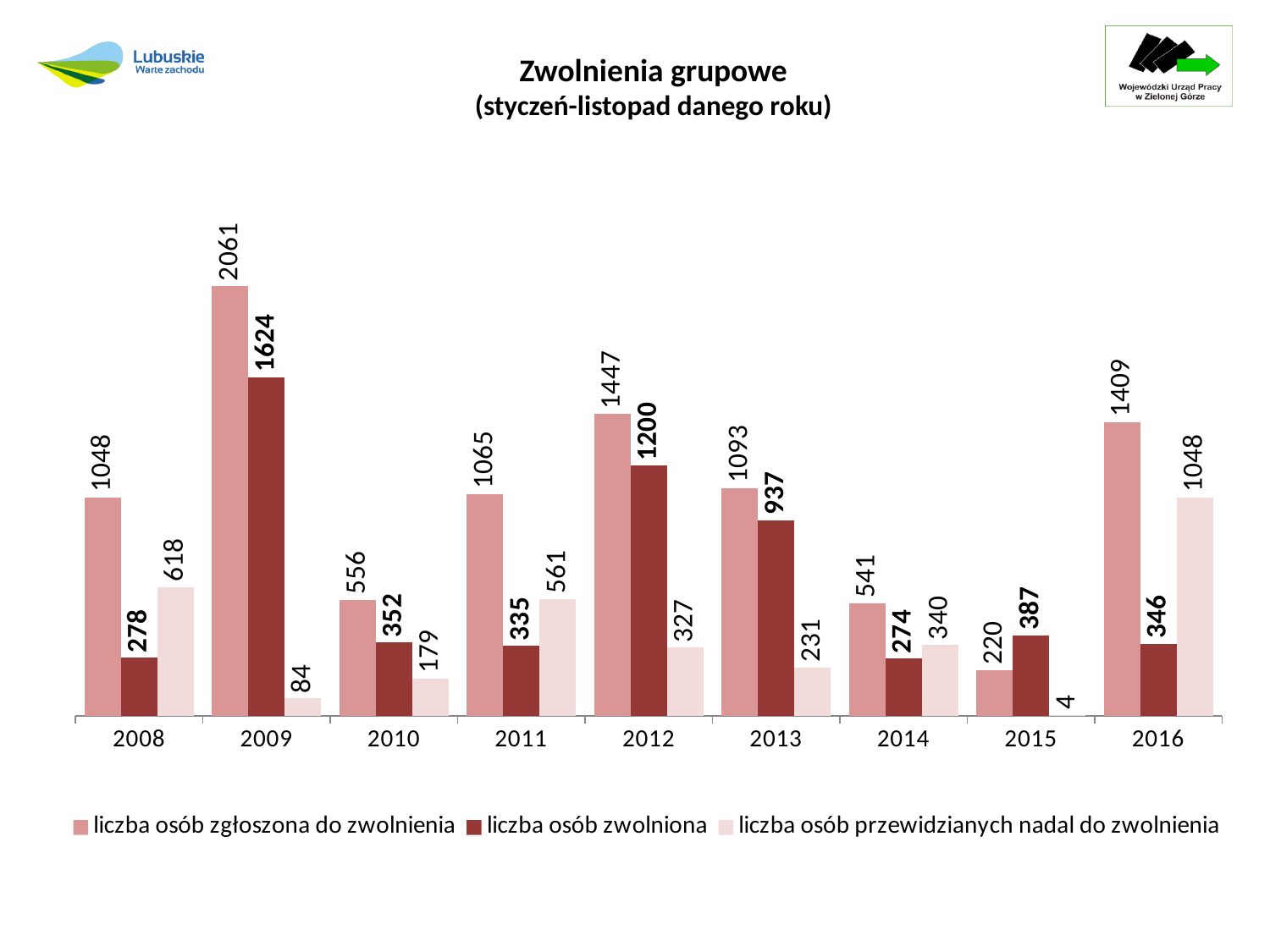
What is the value of 'liczba osób zgłoszona do zwolnienia' for 2009? 2061 How many series does the legend list? 3 Which year has the highest value for 'liczba osób zgłoszona do zwolnienia'? 2009 What is the value of 'liczba osób zwolniona' for 2012? 1200 What is the value of 'liczba osób przewidzianych nadal do zwolnienia' for 2015? 4 How many years are shown on the x axis? 9 What is the difference between 'liczba osób zgłoszona do zwolnienia' and 'liczba osób zwolniona' in 2016? 1063 Which year has the lowest value for 'liczba osób zwolniona'? 2014 What kind of chart is shown on the slide? bar chart Which is larger: 'liczba osób przewidzianych nadal do zwolnienia' in 2008 or in 2011? 2008 Does 'liczba osób zgłoszona do zwolnienia' rise or fall from 2012 to 2015? fall What is the title of the chart? Zwolnienia grupowe (styczeń-listopad danego roku)